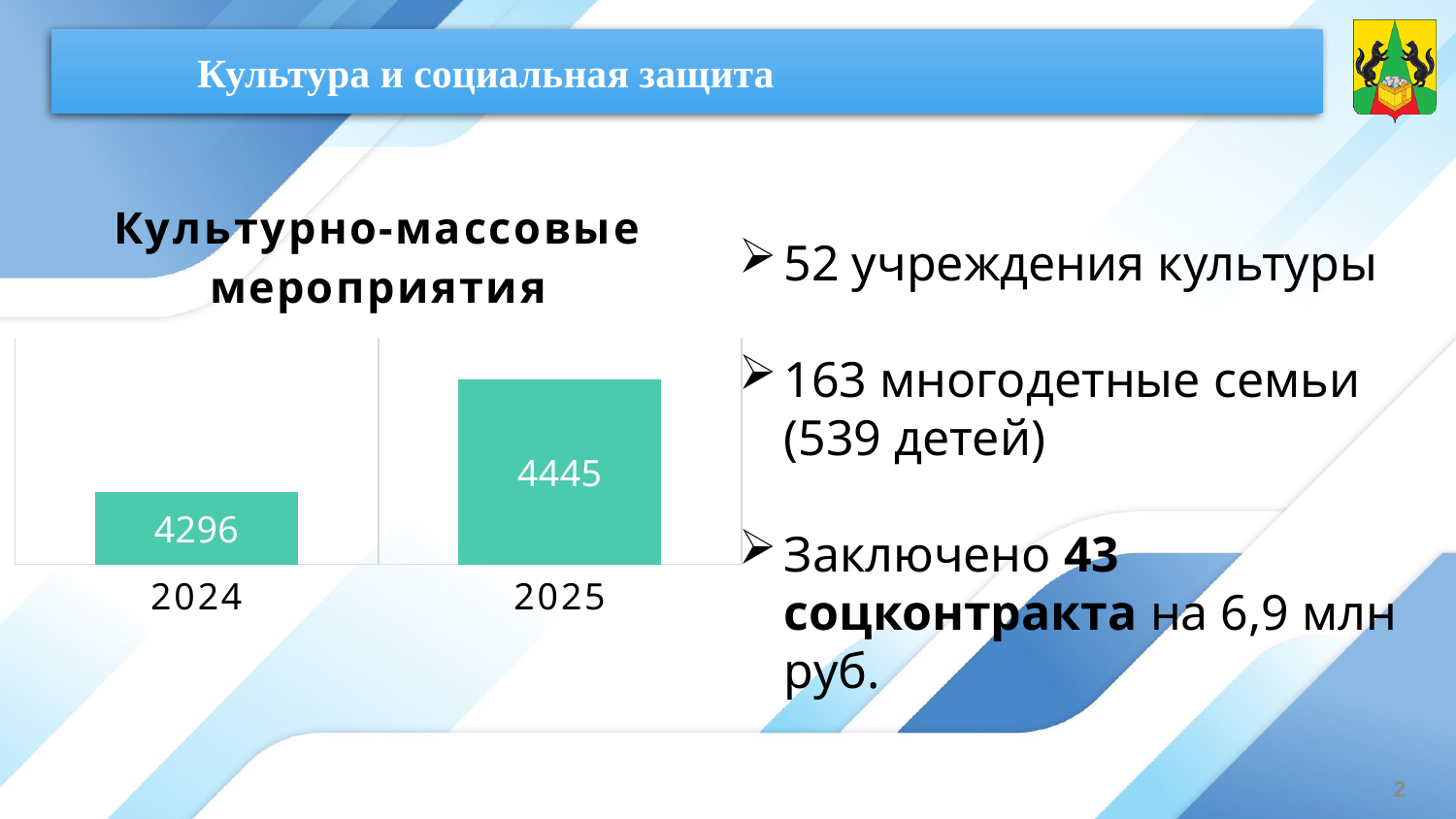
What is the title of the chart? Культурно-массовые мероприятия Is the value for 2025 larger or smaller than the value for 2024? larger Which year has the higher value in the chart? 2025 What kind of chart is shown on the slide? bar chart How many categories are shown in the chart? 2 Do the values rise or fall from 2024 to 2025? rise What colour are the bars in the chart? green What is the difference between the 2025 and 2024 values in the chart? 149 What is the value for 2024 in the chart? 4296 Which year has the lower value in the chart? 2024 What is the value for 2025 in the chart? 4445